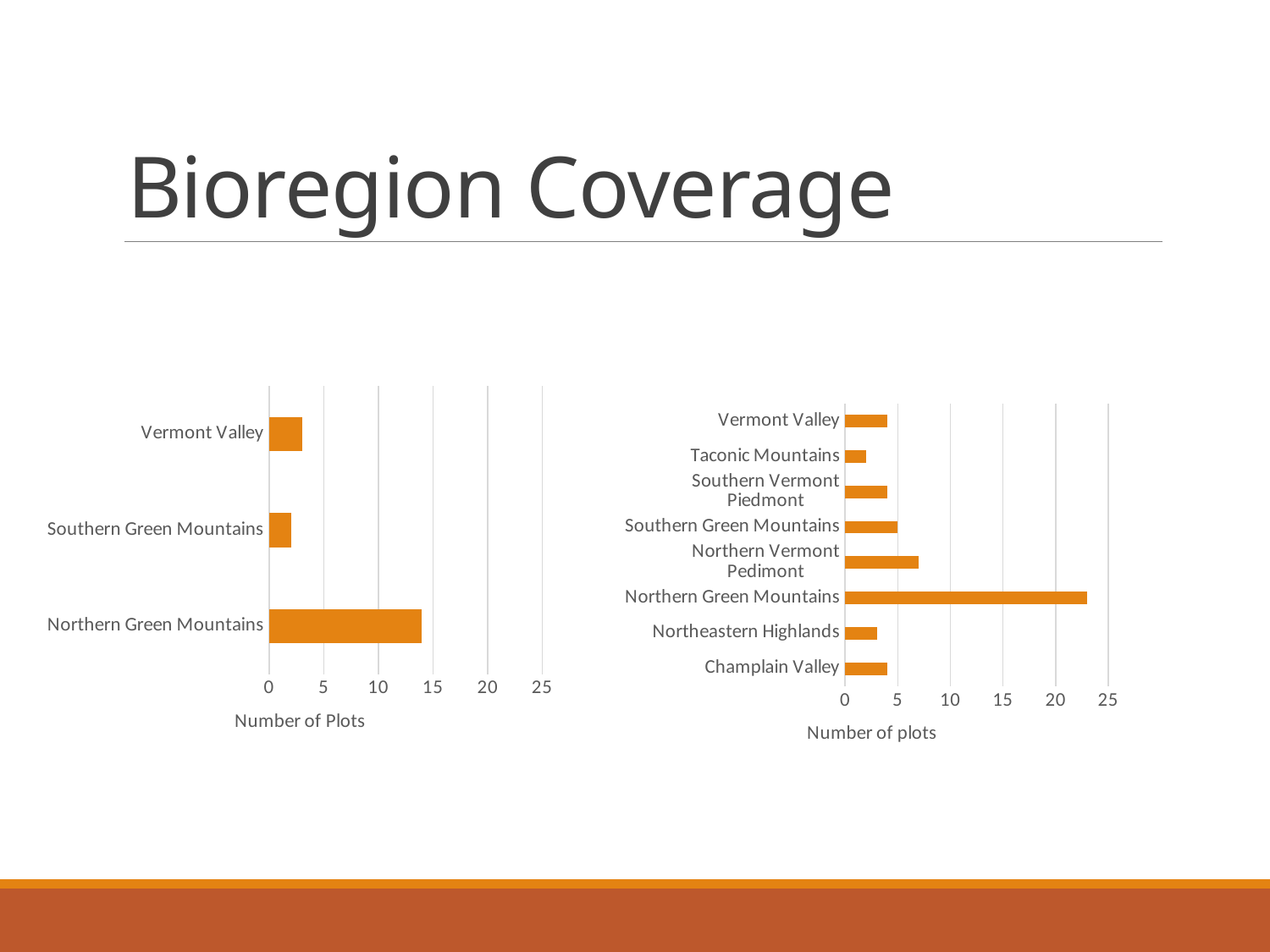
In the chart on the right of the slide, is the value for Northern Green Mountains greater or less than 20? greater What is the x-axis title of the chart on the left of the slide? Number of Plots How many categories does the chart on the right of the slide show? 8 In the chart on the left of the slide, is the value for Vermont Valley greater or less than 5? less In the chart on the left of the slide, is the value for Northern Green Mountains greater or less than 10? greater How many categories does the chart on the left of the slide show? 3 In the chart on the right of the slide, which bioregion has the highest number of plots? Northern Green Mountains In the chart on the right of the slide, which is larger: the value for Northern Vermont Pedimont or the value for Southern Green Mountains? Northern Vermont Pedimont In the chart on the left of the slide, which bioregion has the highest number of plots? Northern Green Mountains What kind of chart is the chart on the left of the slide? bar chart